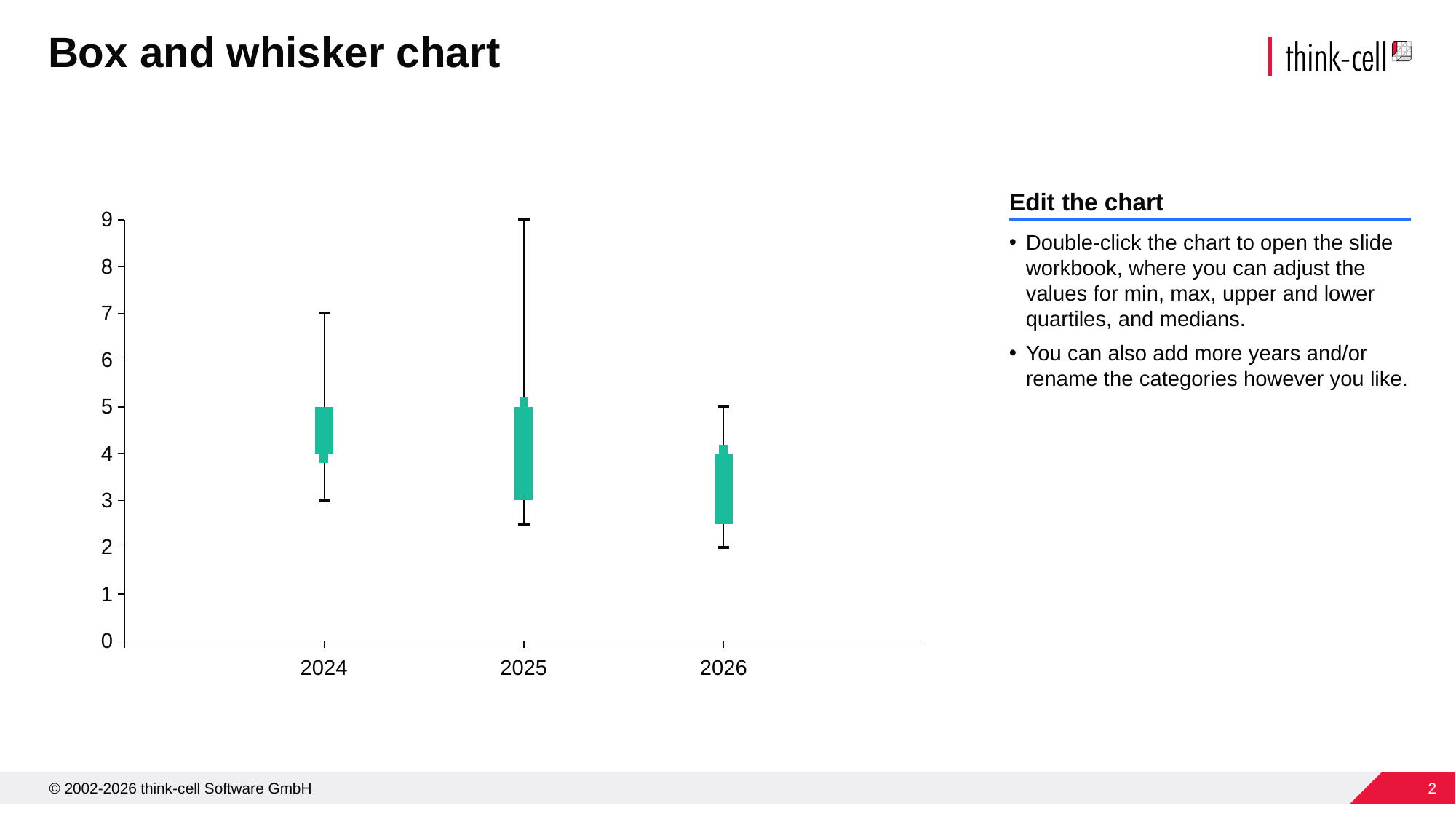
Is the lower whisker (minimum) value for 2025 greater or less than 3? less What is the value of the upper whisker (maximum) for 2026? 5 What is the value of the upper whisker (maximum) for 2025? 9 How many categories are shown on the x axis of the chart? 3 What kind of chart is shown on the slide? Box and whisker chart Which year has the highest upper whisker (maximum) value? 2025 What is the difference between the upper whisker and the lower whisker for 2024? 4 Do the lower whisker (minimum) values rise or fall from 2024 to 2026? fall Is the upper whisker (maximum) for 2024 larger or smaller than the upper whisker for 2026? larger Which year has the lowest lower whisker (minimum) value? 2026 What is the value of the upper whisker (maximum) for 2024? 7 What is the value of the lower whisker (minimum) for 2026? 2